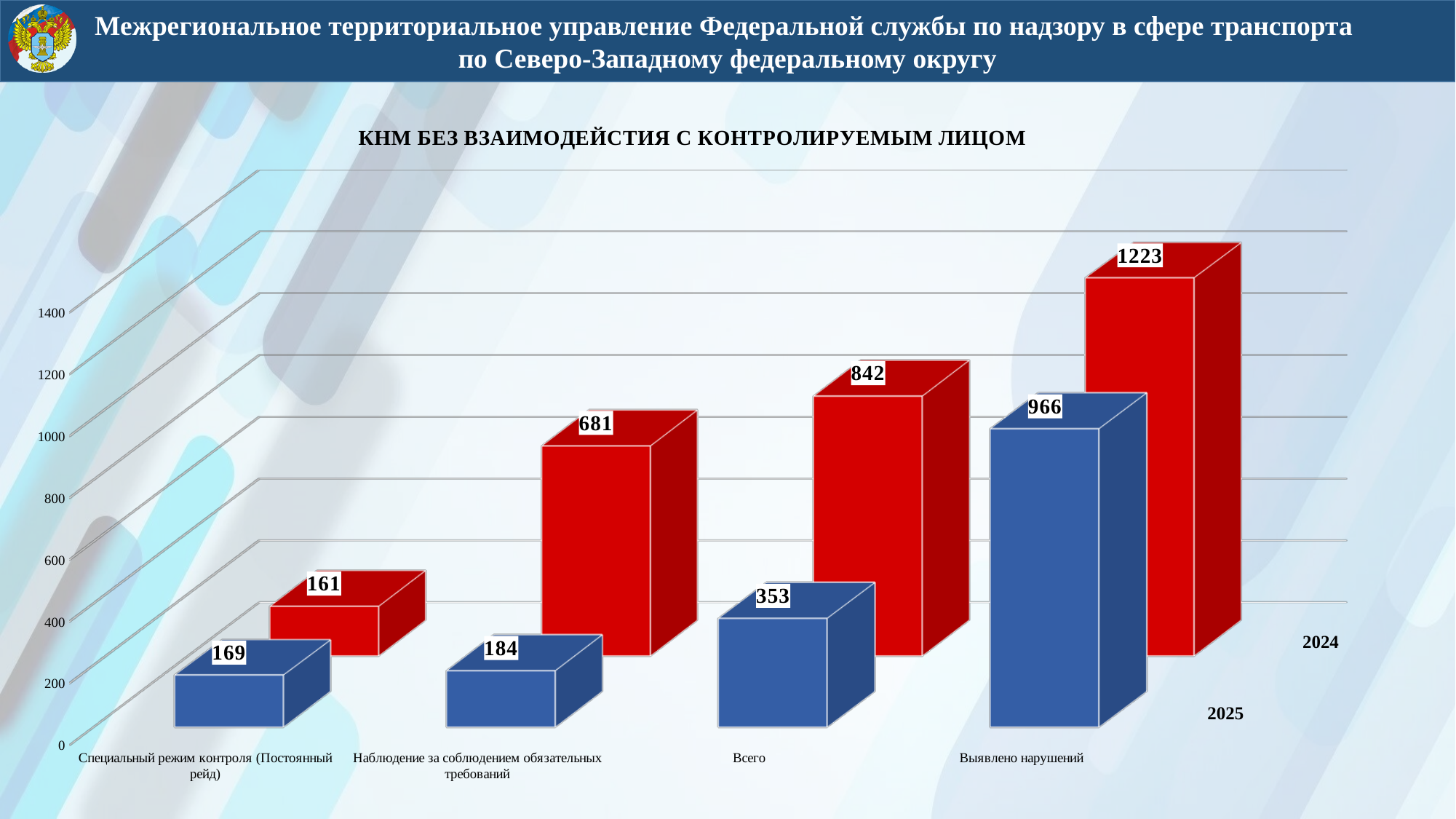
What is the value for 2025 in the category "Наблюдение за соблюдением обязательных требований"? 184 What is the value for 2024 in the category "Специальный режим контроля (Постоянный рейд)"? 161 What kind of chart is shown on the slide? Bar chart What is the value for 2024 in the category "Всего"? 842 What is the value for 2025 in the category "Выявлено нарушений"? 966 Which is larger for "Наблюдение за соблюдением обязательных требований": the 2024 value or the 2025 value? 2024 Which category has the highest value for 2024? Выявлено нарушений What is the difference between the 2024 and 2025 values for "Всего"? 489 What is the title of the chart? КНМ БЕЗ ВЗАИМОДЕЙСТИЯ С КОНТРОЛИРУЕМЫМ ЛИЦОМ Which category has the lowest value for 2025? Специальный режим контроля (Постоянный рейд) How many categories are shown on the x axis? 4 What is the difference between the 2024 and 2025 values for "Выявлено нарушений"? 257